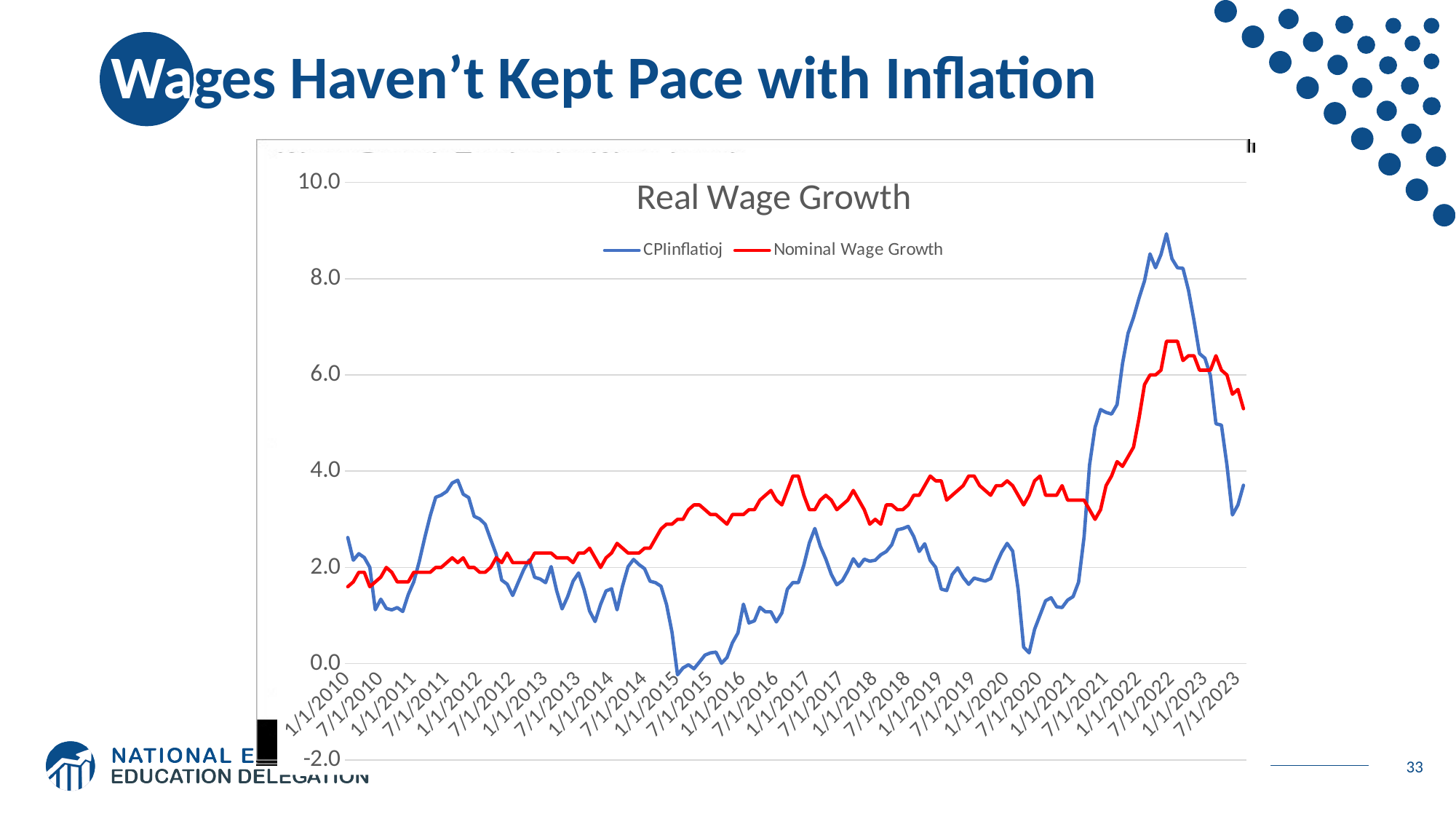
What kind of chart is shown on the slide? line chart What is the title of the chart? Real Wage Growth At 1/1/2019, which series has the higher value, CPIinflatioj or Nominal Wage Growth? Nominal Wage Growth At 7/1/2022, which series has the higher value, CPIinflatioj or Nominal Wage Growth? CPIinflatioj Which colour is used for the Nominal Wage Growth line? red Is the CPIinflatioj value at 7/1/2015 greater or less than 2.0? less Which series reaches the highest value anywhere on the chart? CPIinflatioj Is the peak value of the Nominal Wage Growth line in 2022 greater or less than 6.0? greater How many series does the legend of the chart list? 2 Is the Nominal Wage Growth value at 1/1/2010 greater or less than 2.0? less Does the CPIinflatioj line rise or fall between 1/1/2021 and 7/1/2022? rise